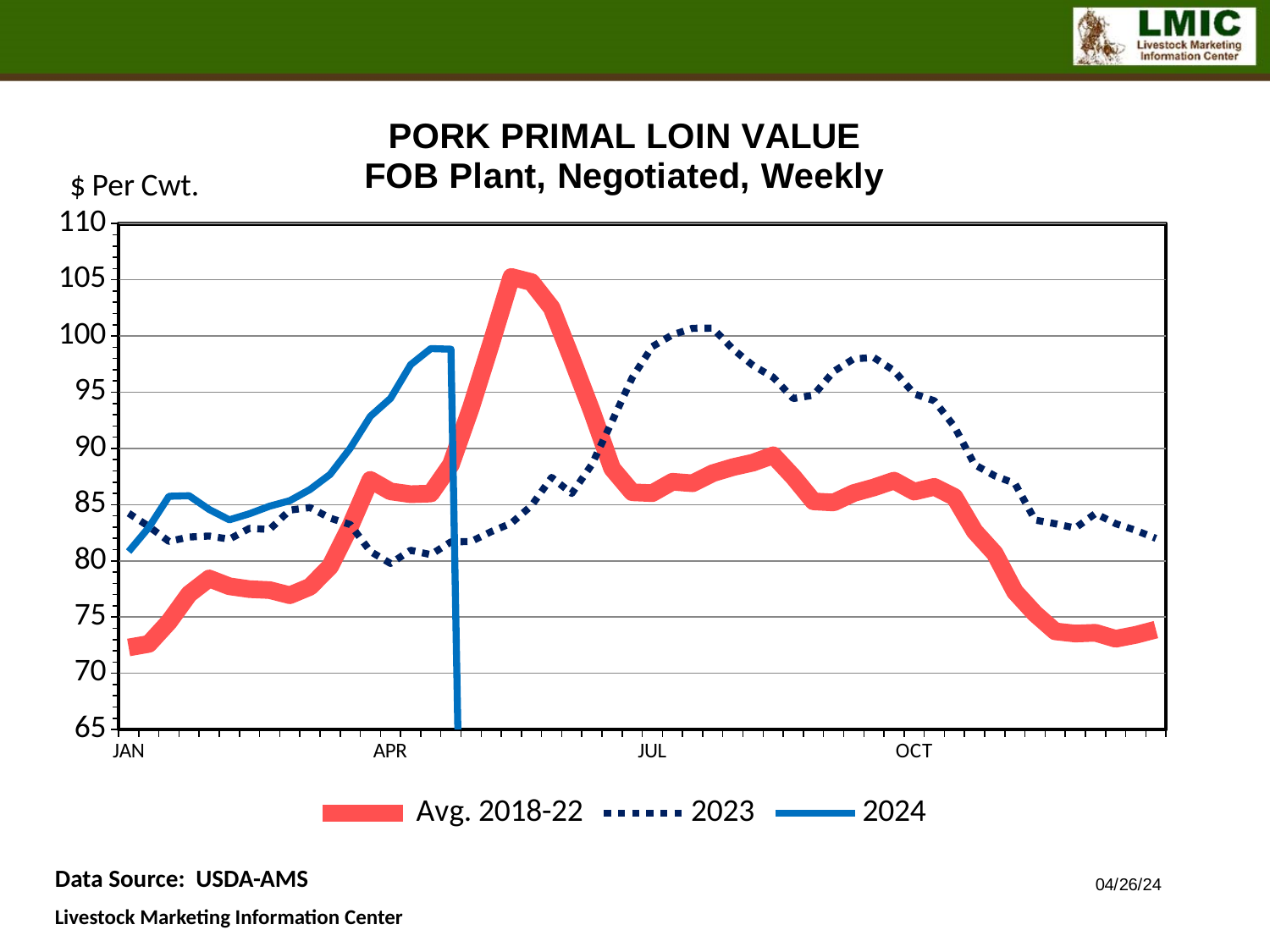
How many series does the legend list? 3 Is the value of the Avg. 2018-22 series at JAN greater or less than 75? less What kind of chart is shown on the slide? Line chart Is the peak value of the 2024 series greater or less than 95? greater Does the Avg. 2018-22 series rise or fall from OCT to the end of the year? fall Is the value of the 2023 series at APR greater or less than 85? less At JAN, which series has the higher value, 2023 or Avg. 2018-22? 2023 At APR, which series has the higher value, 2024 or Avg. 2018-22? 2024 What unit label is shown on the vertical axis of the chart? $ Per Cwt. What is the title of the chart? PORK PRIMAL LOIN VALUE FOB Plant, Negotiated, Weekly